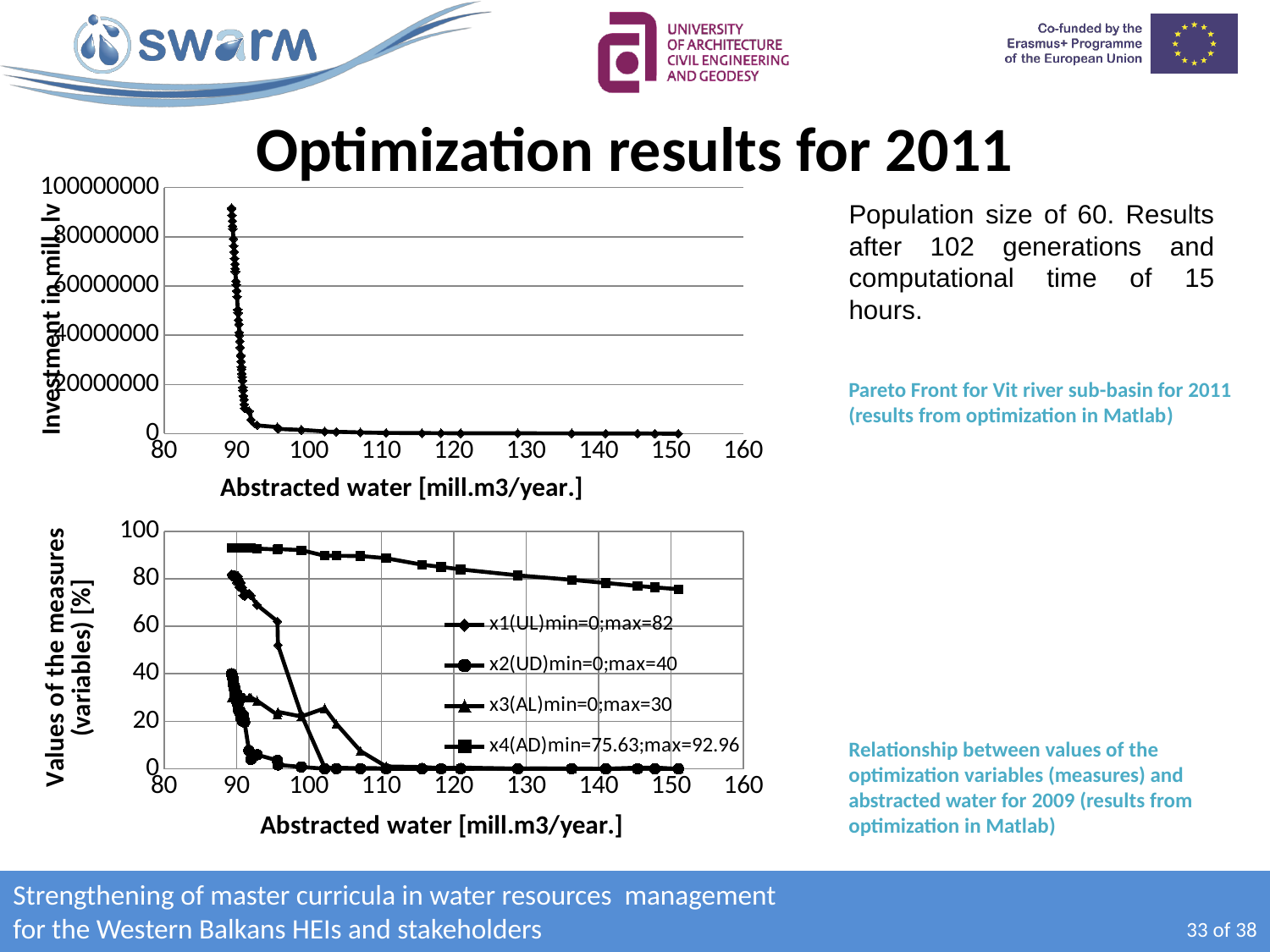
In the bottom chart, at an abstracted water of about 90, which is larger: x4(AD) or x2(UD)? x4(AD) What is the x-axis title of the bottom chart? Abstracted water [mill.m3/year.] In the top chart, is the investment at an abstracted water of 100 greater or less than 20000000? less In the bottom chart, is the value of x4(AD) at an abstracted water of about 90 greater or less than 80? greater In the bottom chart, does the x4(AD) series rise or fall as abstracted water increases along the x axis? fall In the top chart, does the investment rise or fall as abstracted water increases along the x axis? fall In the top chart, is the highest plotted investment value greater or less than 80000000? greater In the bottom chart, which series has the highest values at an abstracted water of 150? x4(AD) According to the legend of the bottom chart, what is the max value given for x4(AD)? 92.96 What kind of chart is the top chart (Investment vs Abstracted water)? line chart How many series does the legend of the bottom chart list? 4